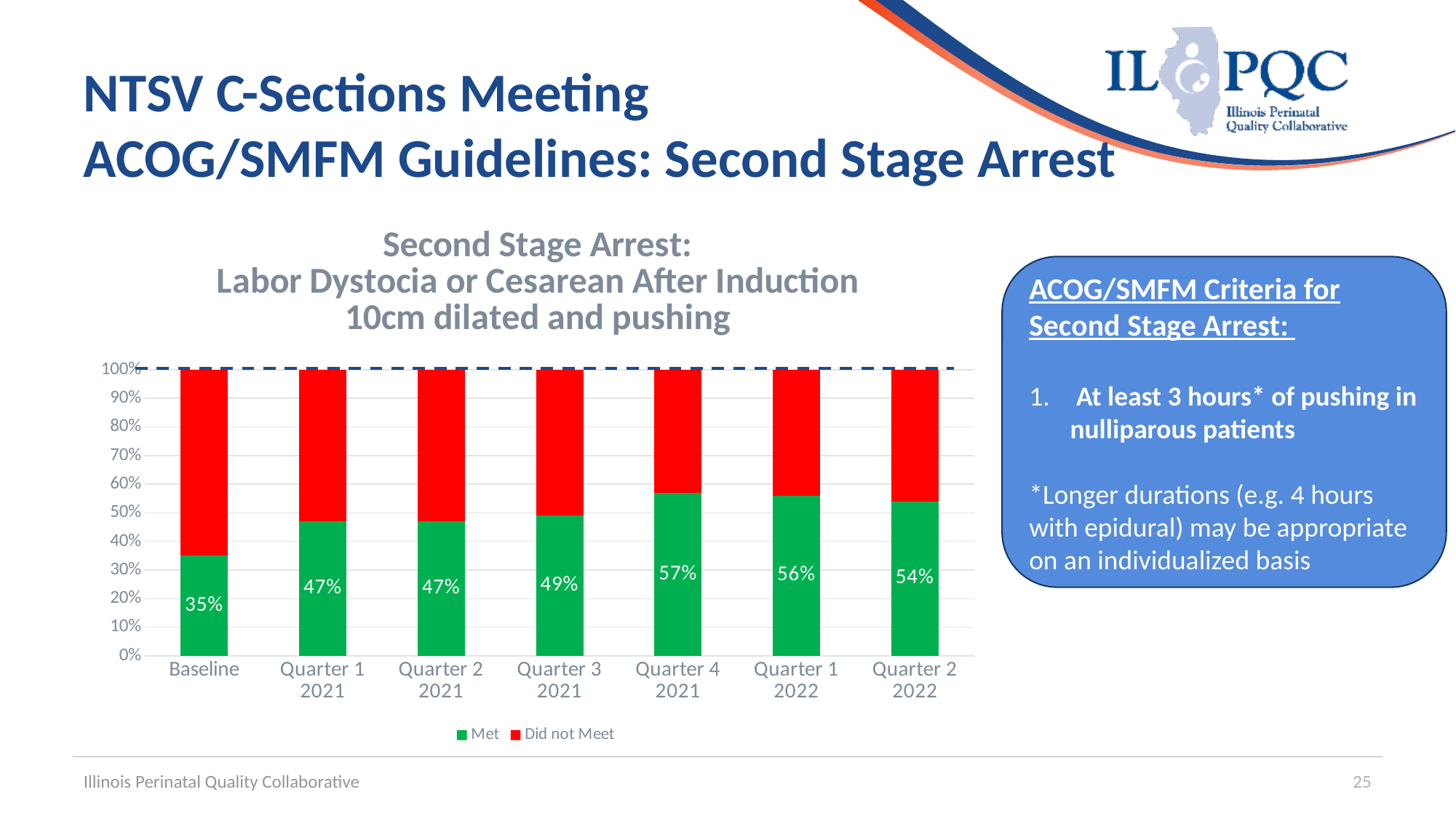
Which category has the lowest 'Met' value? Baseline Which colour represents the 'Did not Meet' series? Red How many categories are shown on the x axis? 7 Is the 'Did not Meet' value for Baseline greater or less than 60%? greater Which category has the highest 'Met' value? Quarter 4 2021 What is the 'Met' value for Quarter 4 2021? 57% What is the 'Met' value for Baseline? 35% What kind of chart is shown on the slide? Stacked bar chart Which is larger, the 'Met' value for Quarter 3 2021 or the 'Met' value for Quarter 1 2022? Quarter 1 2022 What is the difference between the 'Met' value for Quarter 4 2021 and the 'Met' value for Baseline? 22% How many series does the legend list? 2 What is the 'Met' value for Quarter 2 2022? 54%